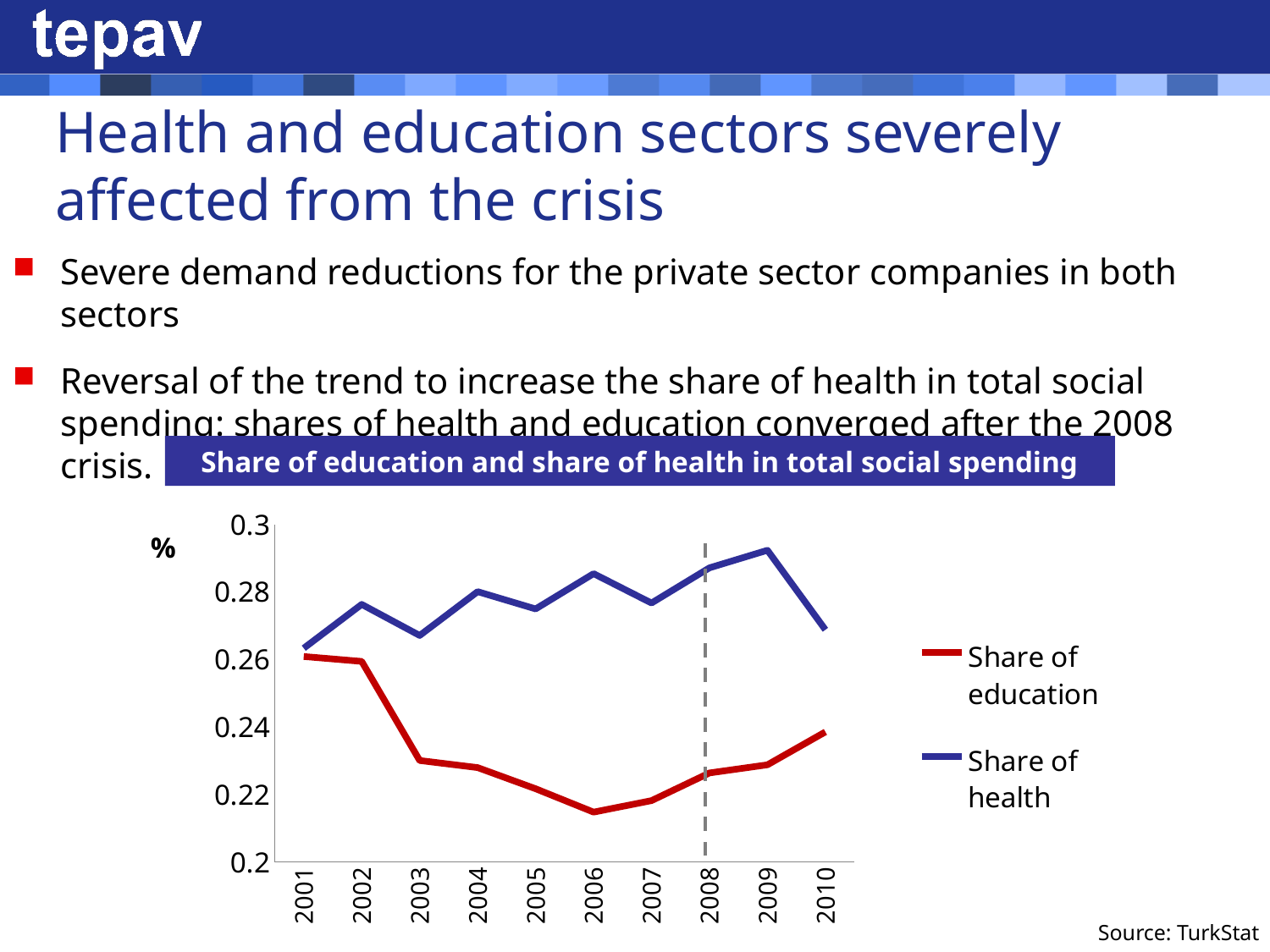
How many years are plotted along the x axis? 10 What is the title of the chart? Share of education and share of health in total social spending Does the Share of education rise or fall from 2006 to 2010? Rise What kind of chart is shown on the slide? Line chart In which year is the Share of education at its lowest? 2006 In 2010, which is larger: Share of health or Share of education? Share of health Is the value for Share of health in 2009 greater or less than 0.28? greater Is the value for Share of education in 2003 greater or less than 0.24? less Is the value for Share of health in 2010 greater or less than 0.28? less How many series does the legend list? 2 In which year is the Share of health at its highest? 2009